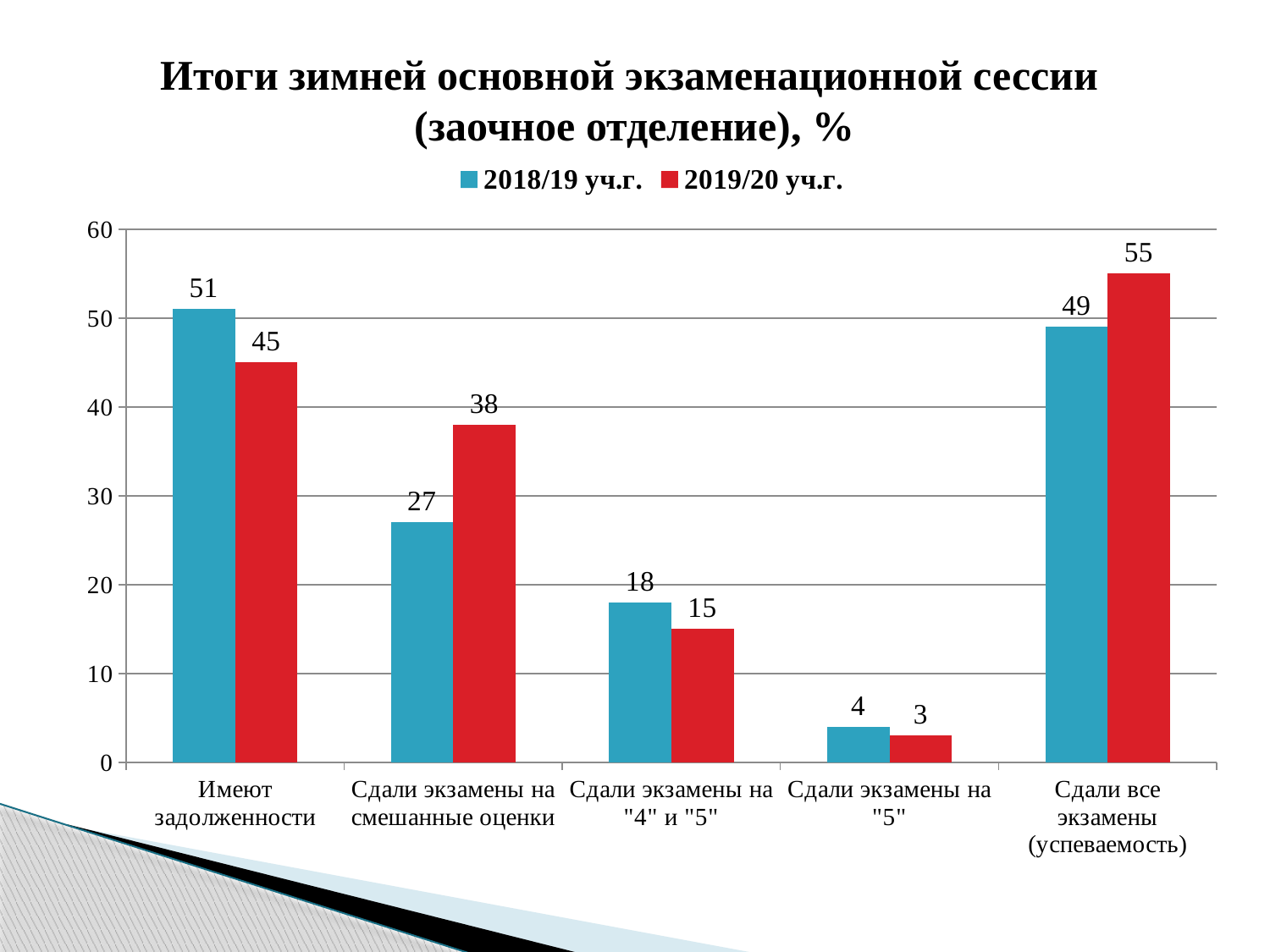
What is the difference between the 2018/19 уч.г. and 2019/20 уч.г. values for "Сдали экзамены на смешанные оценки"? 11 Which category has the highest value in the 2019/20 уч.г. series? Сдали все экзамены (успеваемость) What kind of chart is shown on the slide? Bar chart What is the value for "Сдали экзамены на "5"" in the 2019/20 уч.г. series? 3 Which colour represents the 2019/20 уч.г. series? Red What is the value for "Имеют задолженности" in the 2018/19 уч.г. series? 51 How many series does the legend list? 2 For "Сдали экзамены на "4" и "5"", which series has the larger value, 2018/19 уч.г. or 2019/20 уч.г.? 2018/19 уч.г. How many categories are shown on the x axis? 5 What is the difference between the 2019/20 уч.г. and 2018/19 уч.г. values for "Сдали все экзамены (успеваемость)"? 6 Which category has the lowest value in the 2018/19 уч.г. series? Сдали экзамены на "5" What is the value for "Сдали экзамены на смешанные оценки" in the 2019/20 уч.г. series? 38